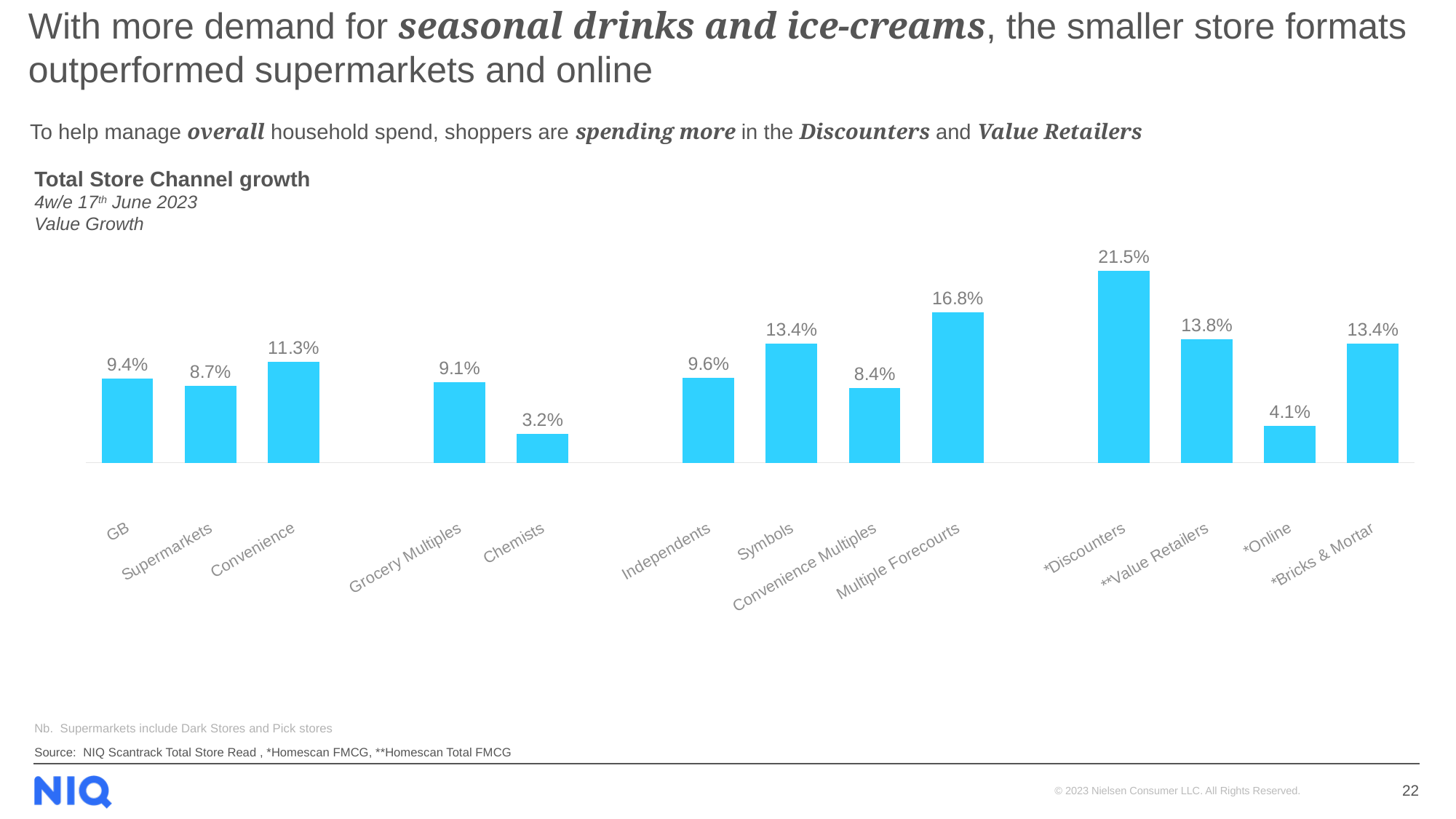
Which channel has the lowest value growth? Chemists How many channels are shown in the chart? 13 What is the difference in value growth between GB and Supermarkets? 0.7% What type of chart is shown on the slide? Bar chart What is the value growth for Convenience? 11.3% What is the value growth for Online? 4.1% What is the difference in value growth between Discounters and Value Retailers? 7.7% What period does the chart cover, according to its subtitle? 4w/e 17th June 2023 Which channel has the highest value growth? Discounters What is the value growth for Chemists? 3.2% What is the value growth for Multiple Forecourts? 16.8% Which has higher value growth, Symbols or Convenience Multiples? Symbols